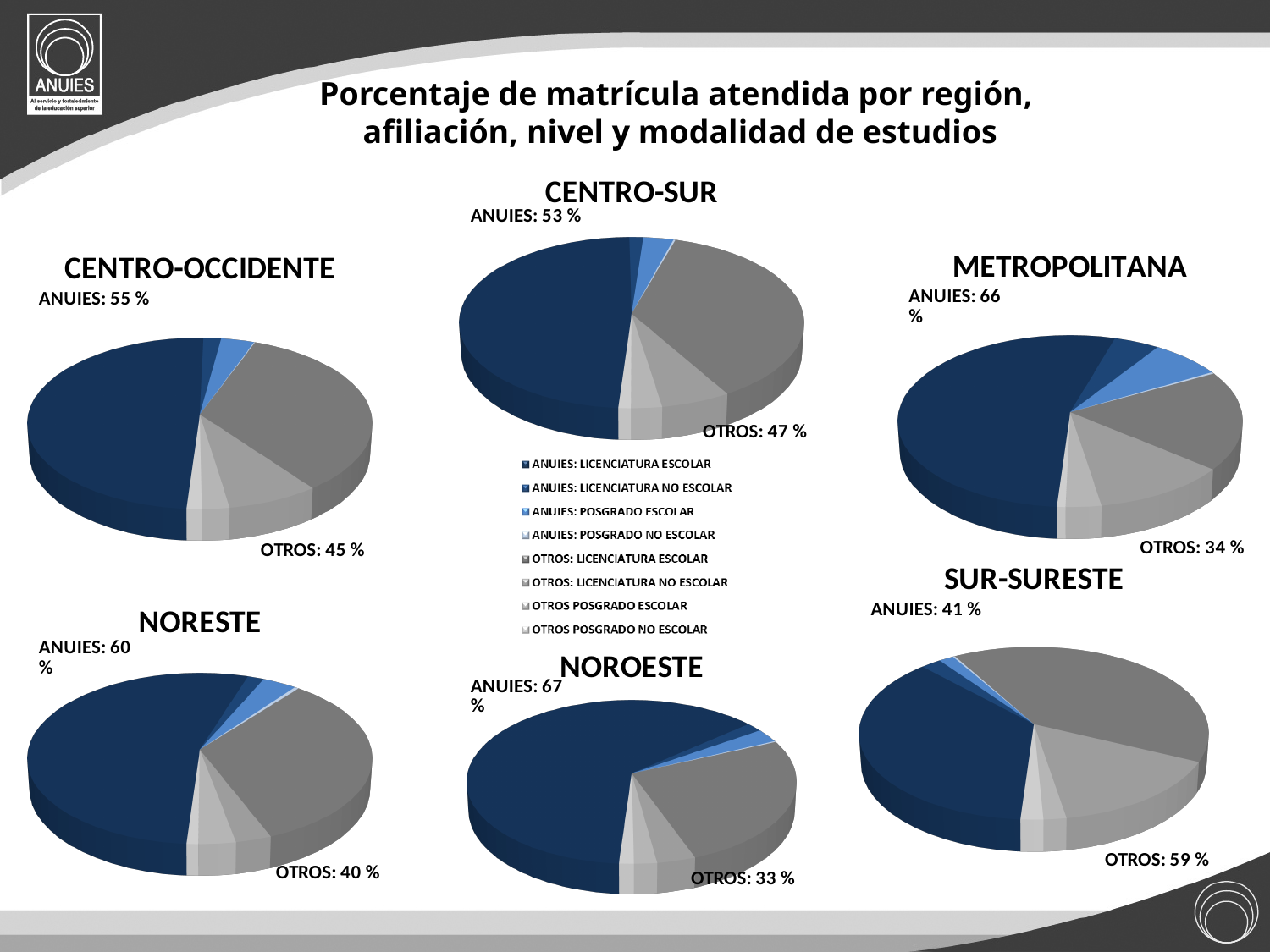
How many entries does the shared legend in the centre of the slide list? 8 Across the six regional charts, which region has the lowest ANUIES percentage? SUR-SURESTE In the NORESTE chart, what is the OTROS percentage? 40 % In the CENTRO-OCCIDENTE chart, what percentage of enrolment is attended by ANUIES? 55 % Across the six regional charts, which region has the highest ANUIES percentage? NOROESTE In the NOROESTE chart, what is the ANUIES percentage? 67 % In the SUR-SURESTE chart, what is the OTROS percentage? 59 % In the SUR-SURESTE chart, which is larger, the ANUIES share or the OTROS share? OTROS In the CENTRO-SUR chart, what percentage is labelled OTROS? 47 % What is the difference between the ANUIES percentage in the METROPOLITANA chart and the ANUIES percentage in the CENTRO-SUR chart? 13 % In the METROPOLITANA chart, what is the ANUIES percentage? 66 % How many pie charts are shown on the slide? 6